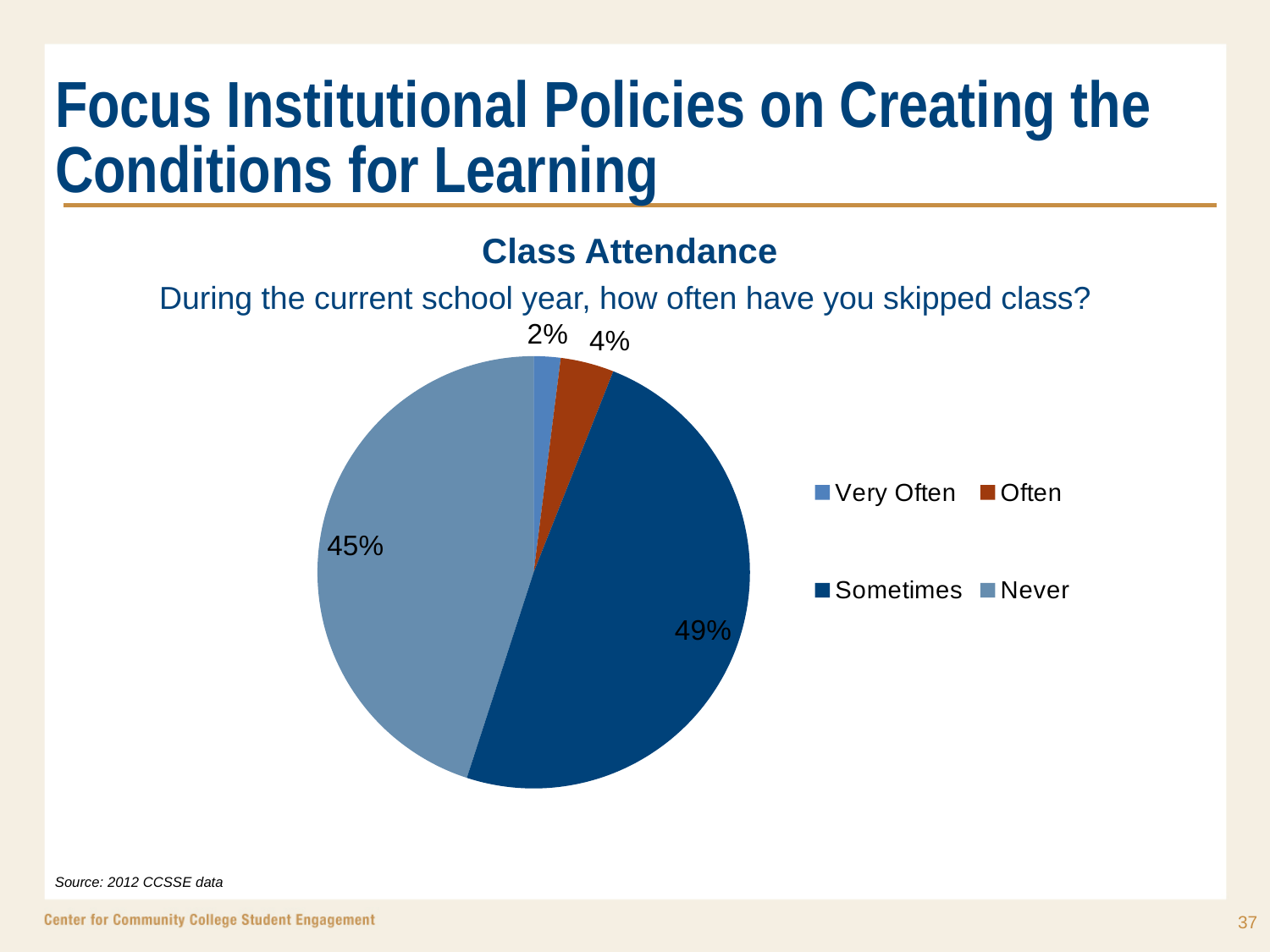
What is the combined share of students who skipped class 'Often' or 'Very Often'? 6% What type of chart is shown on the slide? Pie chart Which response category has the largest share of the pie? Sometimes What percentage of students said they skipped class 'Sometimes'? 49% What percentage of students said they skipped class 'Often'? 4% Which is larger, the share for 'Often' or the share for 'Very Often'? Often Which response category has the smallest share of the pie? Very Often What is the difference in percentage points between 'Sometimes' and 'Never'? 4 What percentage of students said they 'Never' skipped class? 45% What percentage of students said they skipped class 'Very Often'? 2% What is the title of the chart? Class Attendance How many response categories does the pie chart show? 4